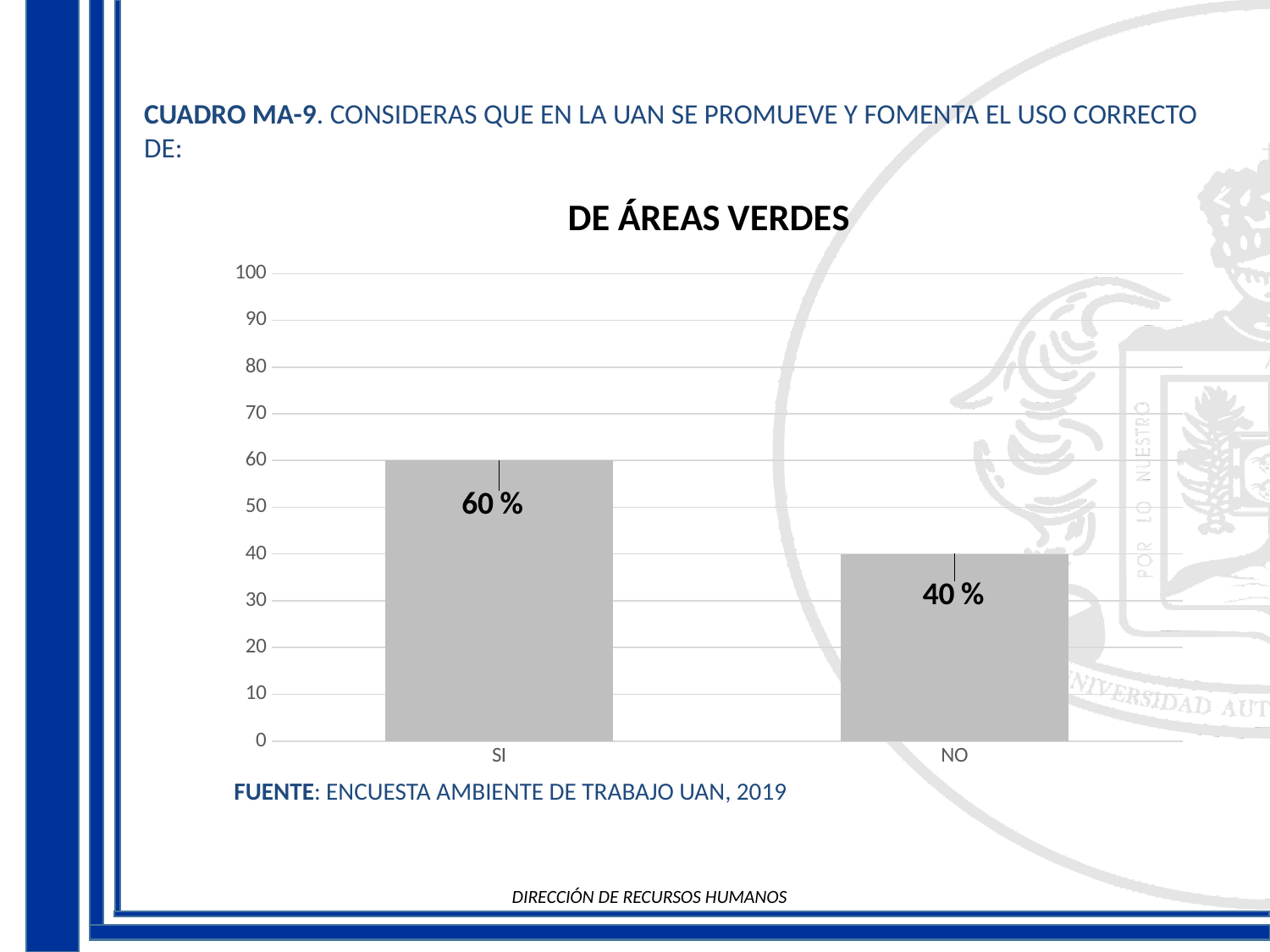
Which category has the lowest value? NO Which category has the highest value? SI What is the title of the chart? DE ÁREAS VERDES What is the value for SI? 60 % What is the maximum value shown on the y axis? 100 What is the difference between the values for SI and NO? 20 % How many categories are shown on the x axis? 2 Is the value for NO greater or less than 50? less Which is larger, the value for SI or the value for NO? SI Is the value for SI greater or less than 50? greater What kind of chart is shown on the slide? bar chart What is the value for NO? 40 %